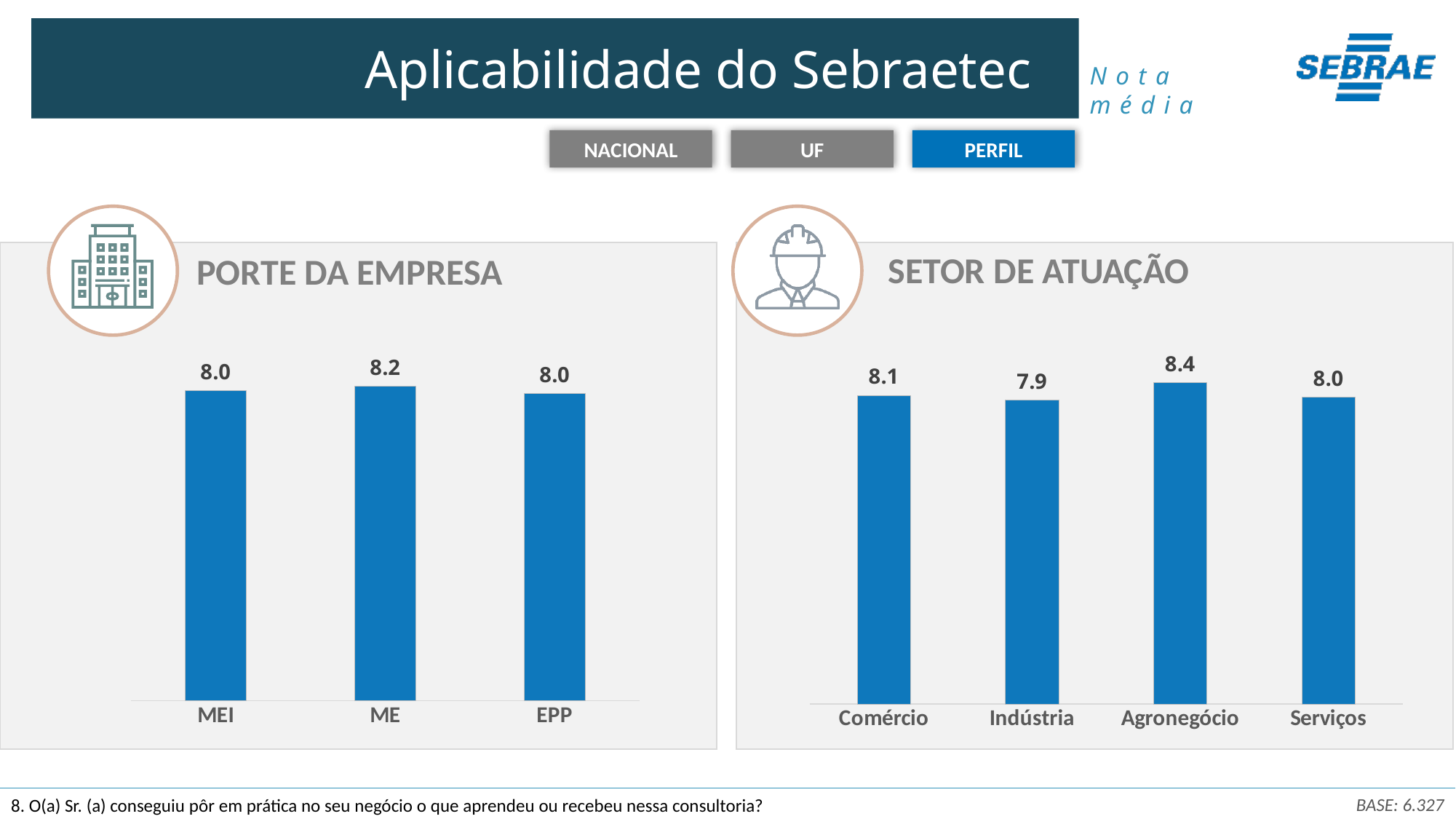
In the PORTE DA EMPRESA chart, how many categories are shown? 3 In the SETOR DE ATUAÇÃO chart, what is the difference between the values for Agronegócio and Indústria? 0.5 In the PORTE DA EMPRESA chart, what is the value for MEI? 8.0 In the PORTE DA EMPRESA chart, what is the difference between the values for ME and EPP? 0.2 What kind of chart is the SETOR DE ATUAÇÃO chart? Bar chart In the SETOR DE ATUAÇÃO chart, what is the value for Indústria? 7.9 In the PORTE DA EMPRESA chart, what is the value for ME? 8.2 In the SETOR DE ATUAÇÃO chart, what is the value for Agronegócio? 8.4 In the SETOR DE ATUAÇÃO chart, which category has the highest value? Agronegócio In the PORTE DA EMPRESA chart, which category has the highest value? ME In the SETOR DE ATUAÇÃO chart, how many categories are shown? 4 In the SETOR DE ATUAÇÃO chart, which category has the lowest value? Indústria